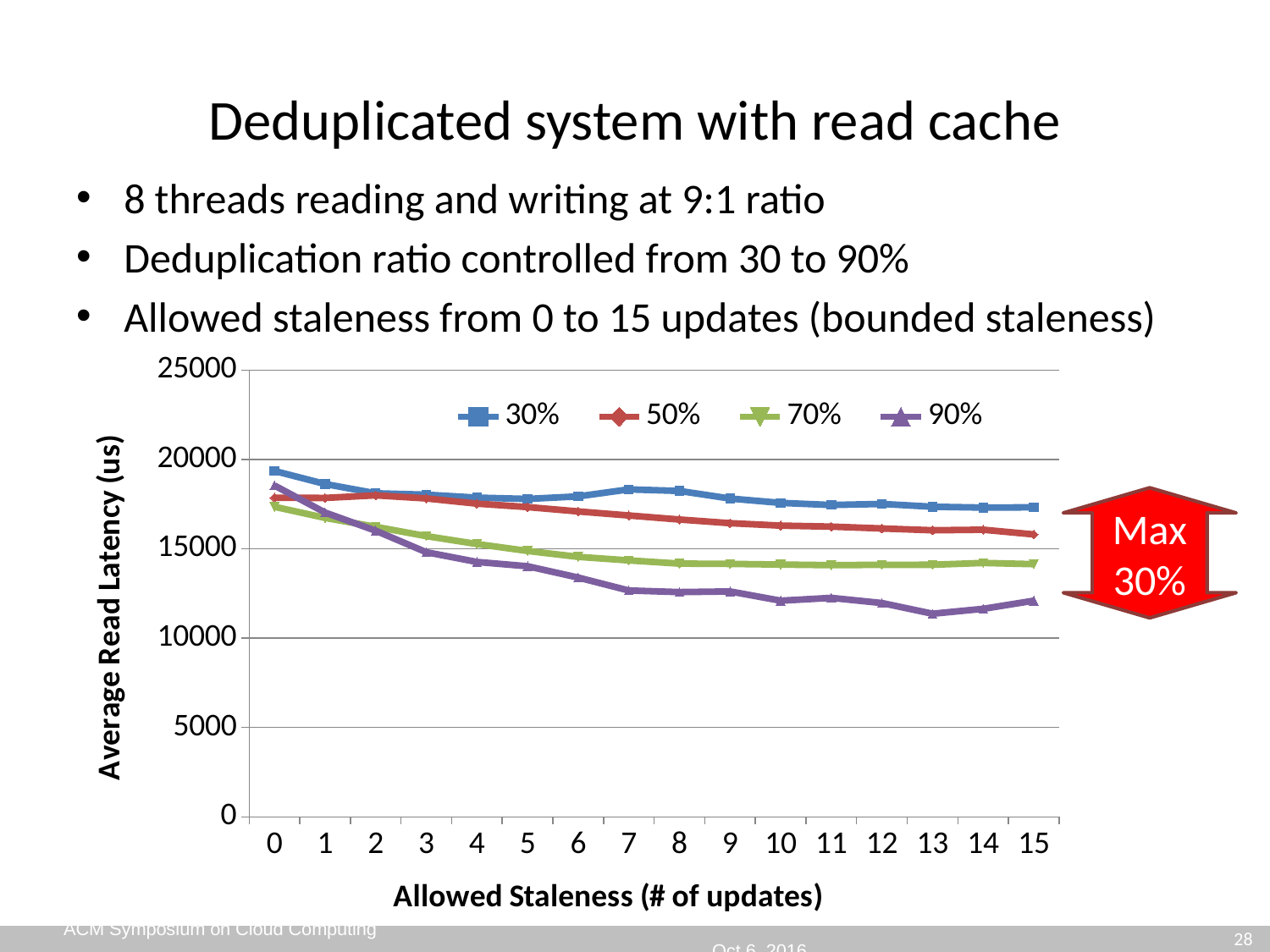
How many series does the legend list? 4 Which series has the lowest average read latency at an allowed staleness of 15? 90% Does the average read latency for the 90% series generally rise or fall as allowed staleness increases? fall What kind of chart is shown on the slide? line chart Which series has the highest average read latency at an allowed staleness of 15? 30% At an allowed staleness of 15, which series has the larger average read latency, 30% or 90%? 30% What is the label of the y axis? Average Read Latency (us) Is the average read latency for the 70% series at an allowed staleness of 15 greater or less than 15000? less How many allowed staleness values are plotted along the x axis? 16 Is the average read latency for the 30% series at an allowed staleness of 0 greater or less than 15000? greater Is the average read latency for the 90% series at an allowed staleness of 13 greater or less than 15000? less What is the label of the x axis? Allowed Staleness (# of updates)